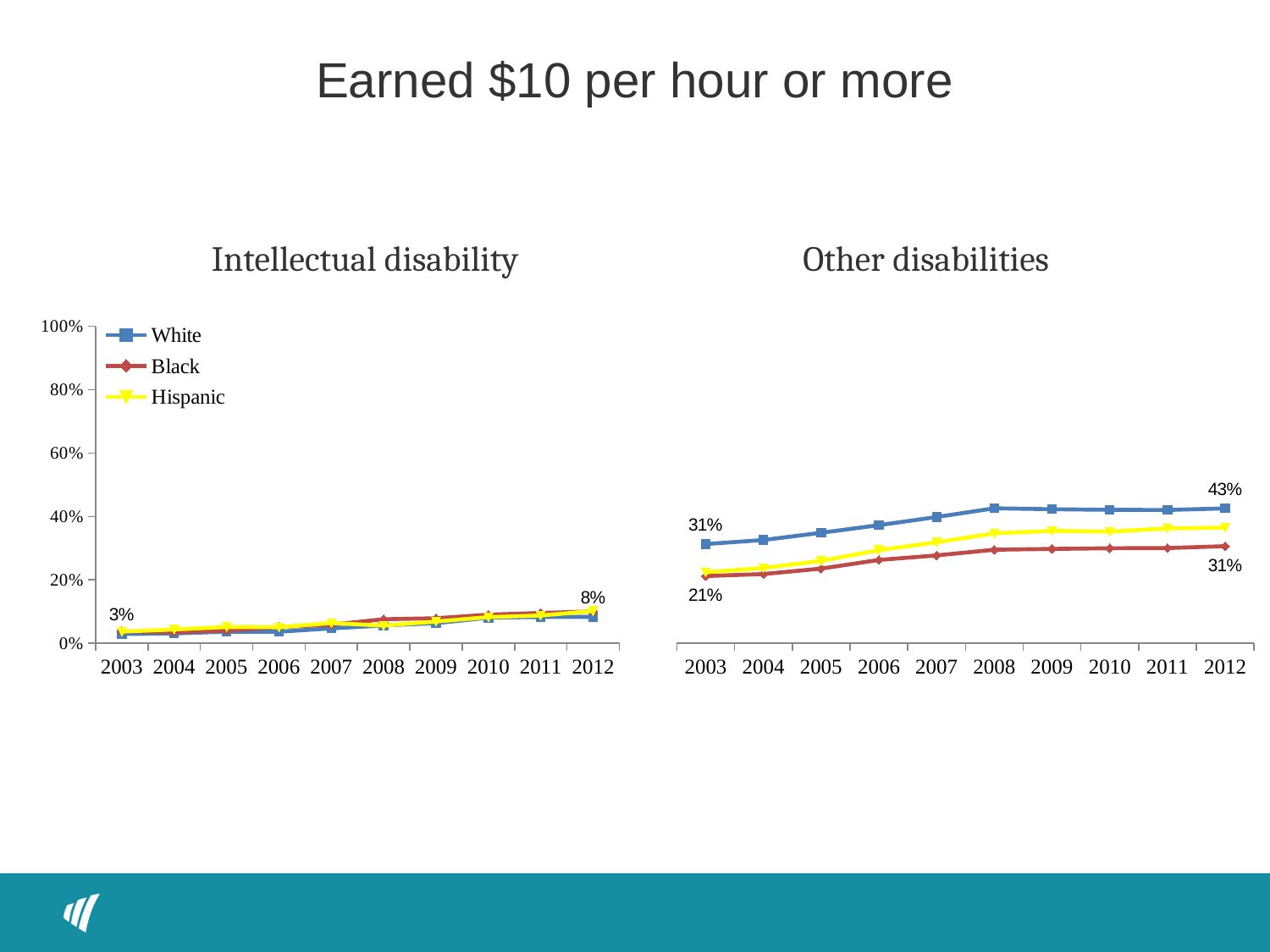
In the Other disabilities chart, by how many percentage points did the White value increase from 2003 to 2012? 12 percentage points In the Intellectual disability chart, what is the value for White in 2003? 3% What type of chart is the Other disabilities chart? Line chart In the Other disabilities chart, what is the value for Black in 2012? 31% How many years are shown on the x axis of the Intellectual disability chart? 10 In the Intellectual disability chart, what is the value for White in 2012? 8% In the Other disabilities chart, which series has the highest value in 2012? White In the Other disabilities chart, is the value for Hispanic in 2012 greater or less than 40%? less In the Other disabilities chart, what is the value for White in 2003? 31% In the Other disabilities chart, what is the difference between the White and Black values in 2012? 12 percentage points In the Other disabilities chart, which is larger in 2003, the White value or the Black value? White How many series does the legend on the Intellectual disability chart list? 3